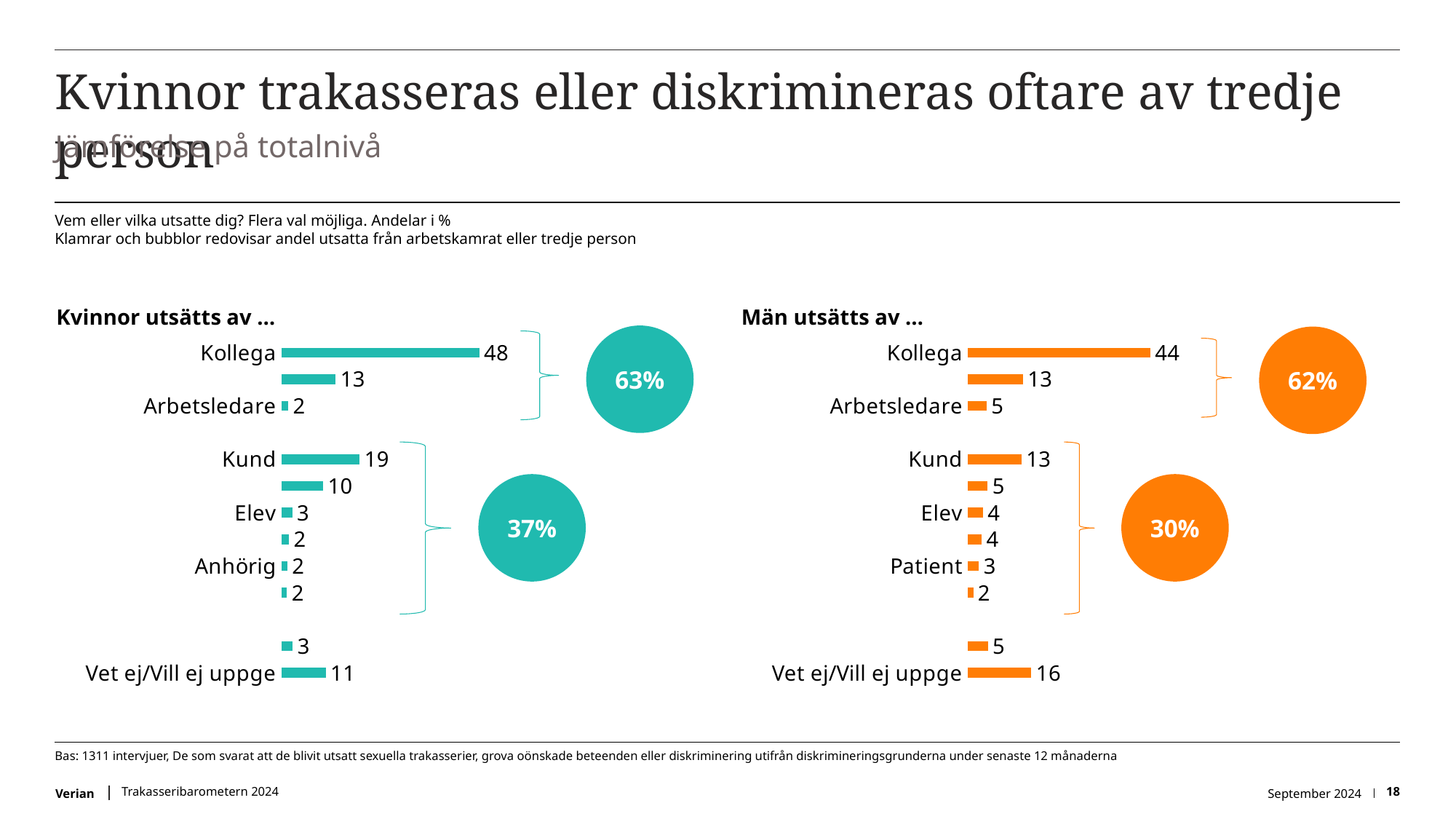
In the 'Kvinnor utsätts av …' chart, what is the difference between Kund and Arbetsledare? 17 What kind of chart is the 'Kvinnor utsätts av …' chart? Bar chart In the 'Kvinnor utsätts av …' chart, which category has the highest value? Kollega In the 'Män utsätts av …' chart, what is the value for Kollega? 44 In the 'Kvinnor utsätts av …' chart, what is the value for Kollega? 48 In the 'Män utsätts av …' chart, what is the value for Vet ej/Vill ej uppge? 16 In the 'Kvinnor utsätts av …' chart, what is the value for Kund? 19 What is the difference between the Kollega value in the 'Kvinnor utsätts av …' chart and the Kollega value in the 'Män utsätts av …' chart? 4 In the 'Män utsätts av …' chart, what is the value for Patient? 3 In the 'Män utsätts av …' chart, which category has the highest value? Kollega What percentage is shown in the upper bubble next to the 'Män utsätts av …' chart? 62% Which is larger: Kund in the 'Kvinnor utsätts av …' chart or Kund in the 'Män utsätts av …' chart? Kund in the 'Kvinnor utsätts av …' chart